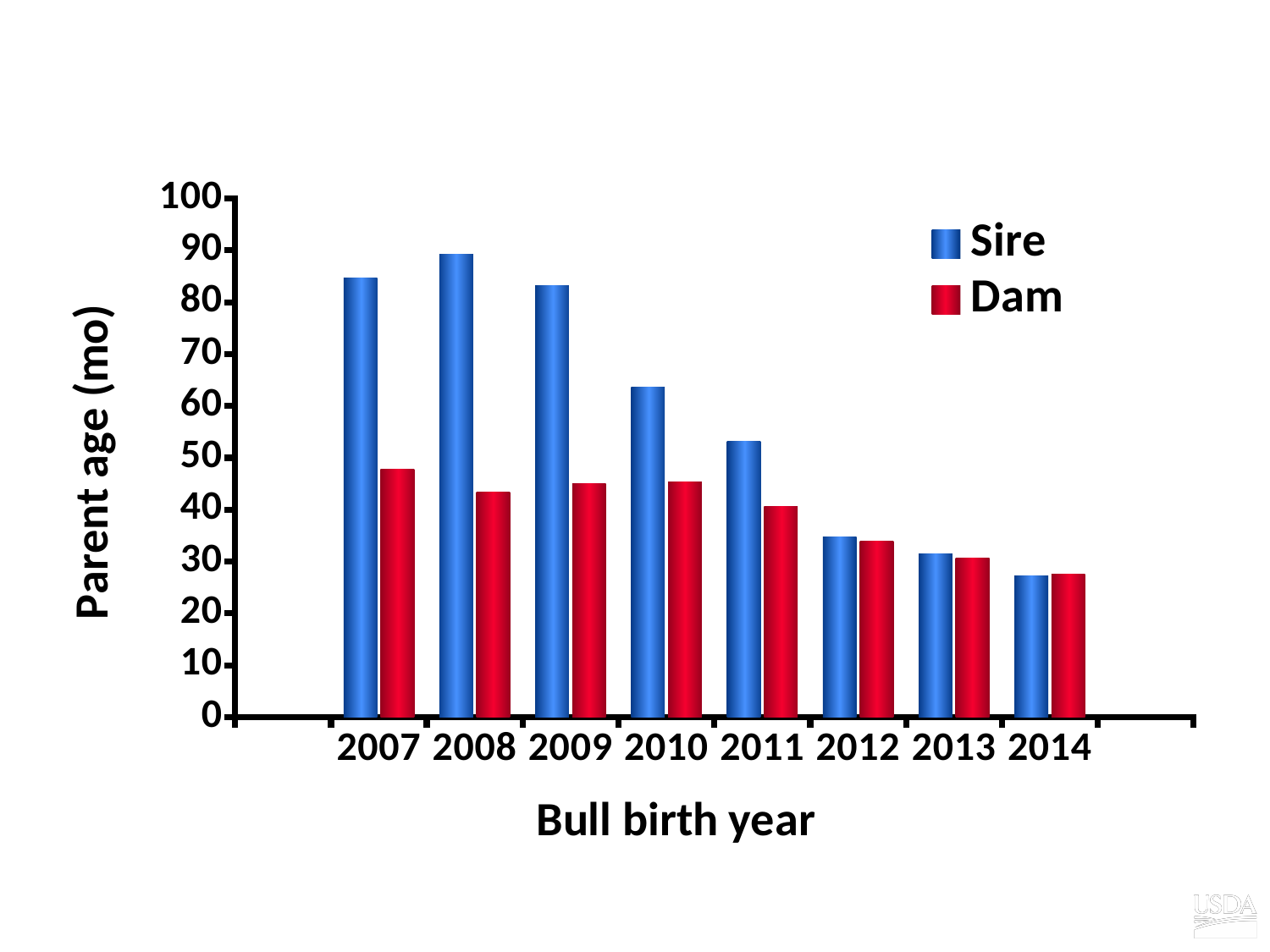
Does the Sire parent age rise or fall from 2009 to 2014? Fall Which is larger for 2007, the Sire parent age or the Dam parent age? Sire Is the Dam parent age for 2007 greater or less than 50? less What is the label of the y axis? Parent age (mo) How many series does the legend list? 2 In which bull birth year is the Sire parent age lowest? 2014 What kind of chart is shown on the slide? Bar chart Is the Sire parent age for 2008 greater or less than 80? greater How many bull birth years are shown on the x axis? 8 In which bull birth year is the Dam parent age highest? 2007 In which bull birth year is the Sire parent age highest? 2008 Is the Sire parent age for 2010 greater or less than 60? greater